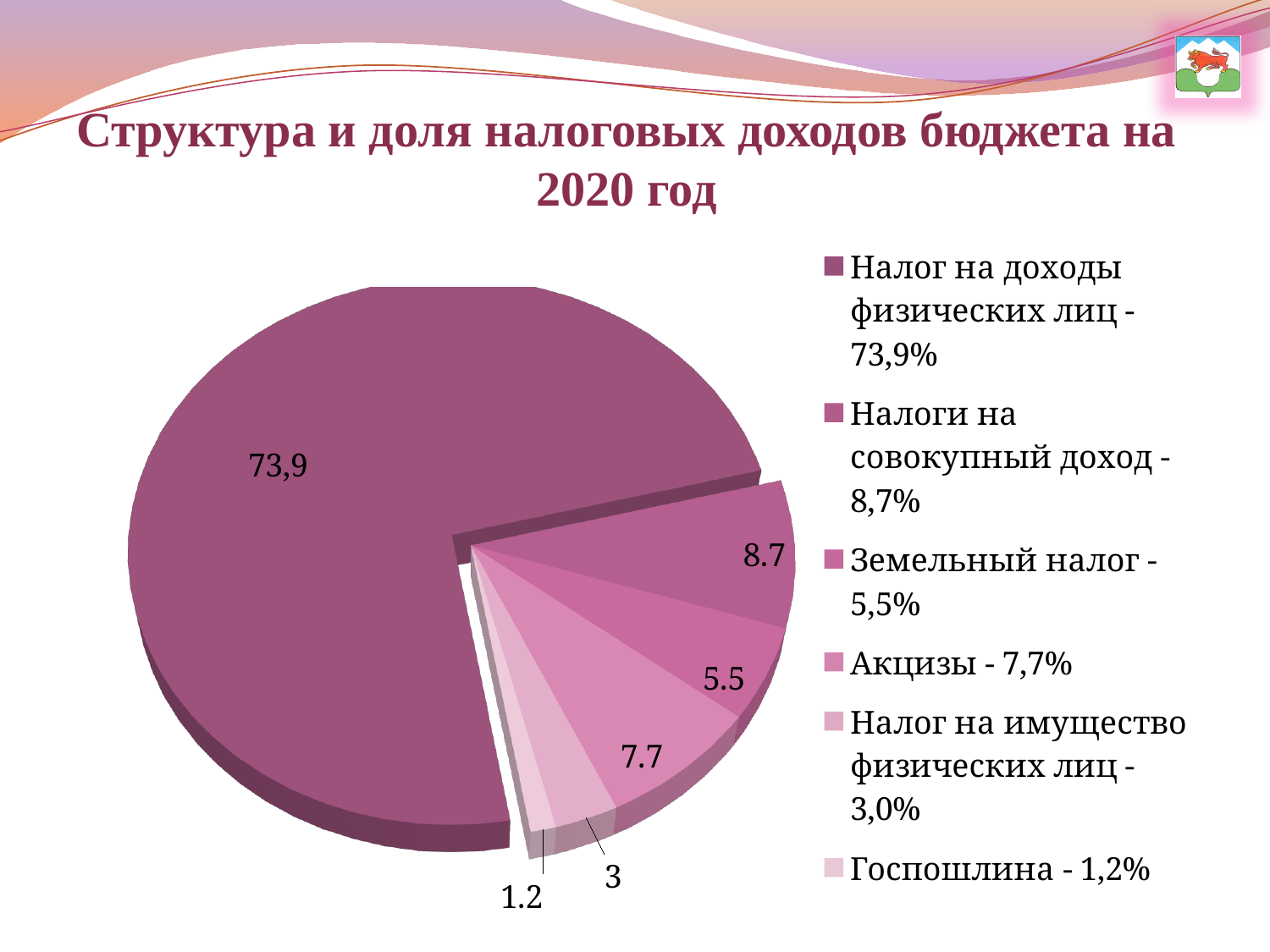
What value is labelled on the slice for Земельный налог? 5.5 According to the legend, what share does Налог на имущество физических лиц have? 3,0% How many slices does the pie chart have? 6 What is the title of the chart on the slide? Структура и доля налоговых доходов бюджета на 2020 год What type of chart is shown on the slide? pie chart What is the difference between the values labelled for Налоги на совокупный доход (8.7) and Госпошлина (1.2)? 7.5 According to the legend, what share does Налоги на совокупный доход have? 8,7% What value is labelled on the largest slice of the pie chart? 73,9 What value is labelled on the slice for Акцизы? 7.7 Which category has the smallest share of the pie chart? Госпошлина Which is larger: the slice for Акцизы or the slice for Земельный налог? Акцизы Which category has the largest share of the pie chart? Налог на доходы физических лиц